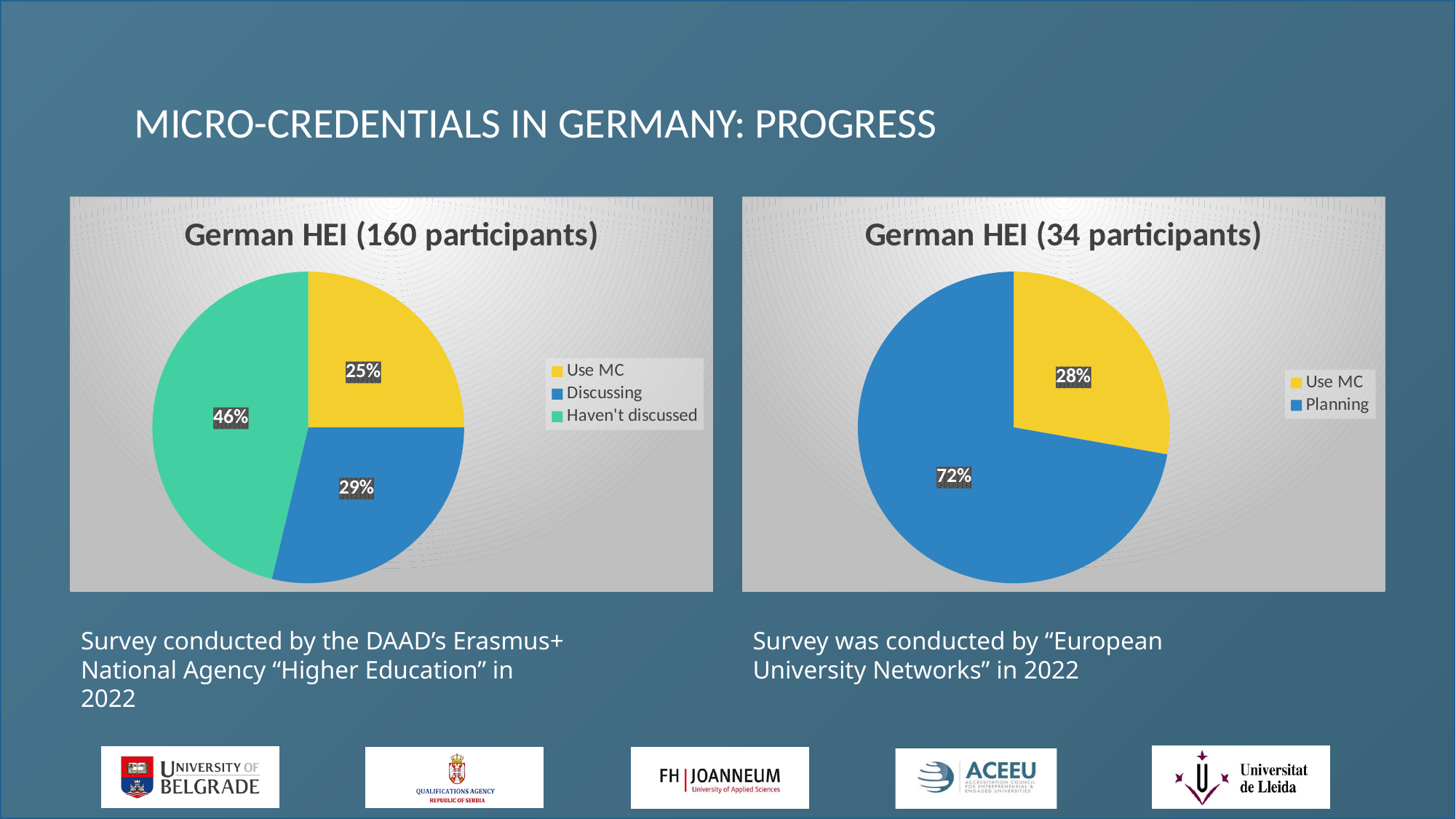
In the 'German HEI (160 participants)' chart, what share of the pie is 'Discussing'? 29% What kind of chart is the 'German HEI (34 participants)' chart? Pie chart In the 'German HEI (34 participants)' chart, what is the difference between 'Planning' and 'Use MC'? 44% In the 'German HEI (160 participants)' chart, which category has the largest slice? Haven't discussed In the 'German HEI (34 participants)' chart, what share of the pie is 'Planning'? 72% In the 'German HEI (34 participants)' chart, which is larger, 'Use MC' or 'Planning'? Planning In the 'German HEI (160 participants)' chart, what share of the pie is 'Use MC'? 25% In the 'German HEI (160 participants)' chart, what is the difference between 'Haven't discussed' and 'Discussing'? 17% In the 'German HEI (160 participants)' chart, how many categories does the legend list? 3 In the 'German HEI (160 participants)' chart, what colour is the 'Haven't discussed' slice? Green In the 'German HEI (160 participants)' chart, which category has the smallest slice? Use MC